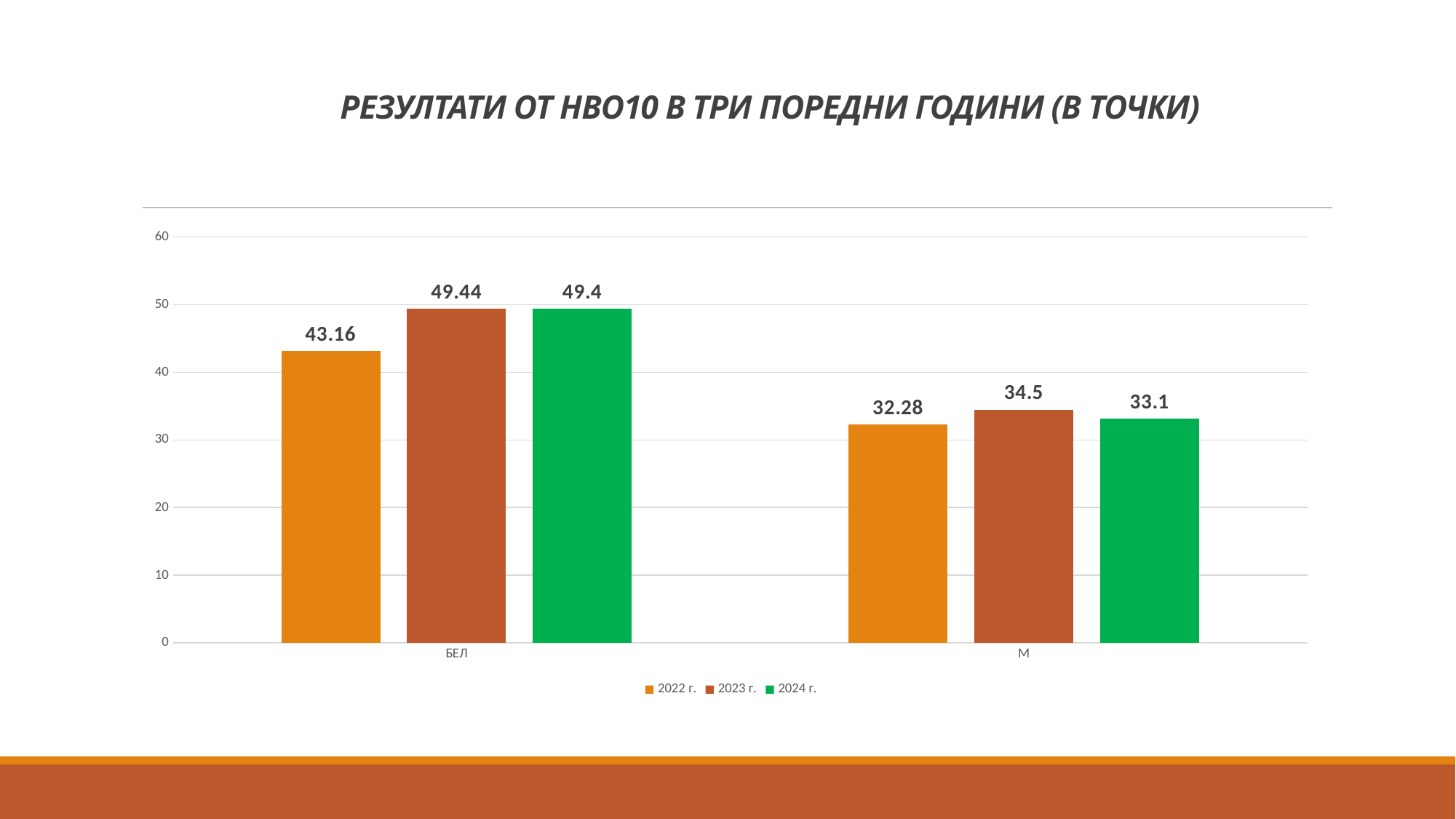
What is the value for БЕЛ in 2024 г.? 49.4 How many categories are shown on the x axis? 2 Which is larger: the 2024 г. value for БЕЛ or the 2024 г. value for М? БЕЛ What is the value for М in 2022 г.? 32.28 What is the difference between the 2023 г. and 2024 г. values for М? 1.4 How many series does the legend list? 3 What is the value for М in 2023 г.? 34.5 What is the difference between the 2023 г. and 2022 г. values for БЕЛ? 6.28 Which year has the highest value for М? 2023 г. What kind of chart is shown on the slide? Bar chart Which year has the lowest value for БЕЛ? 2022 г. What is the value for БЕЛ in 2022 г.? 43.16